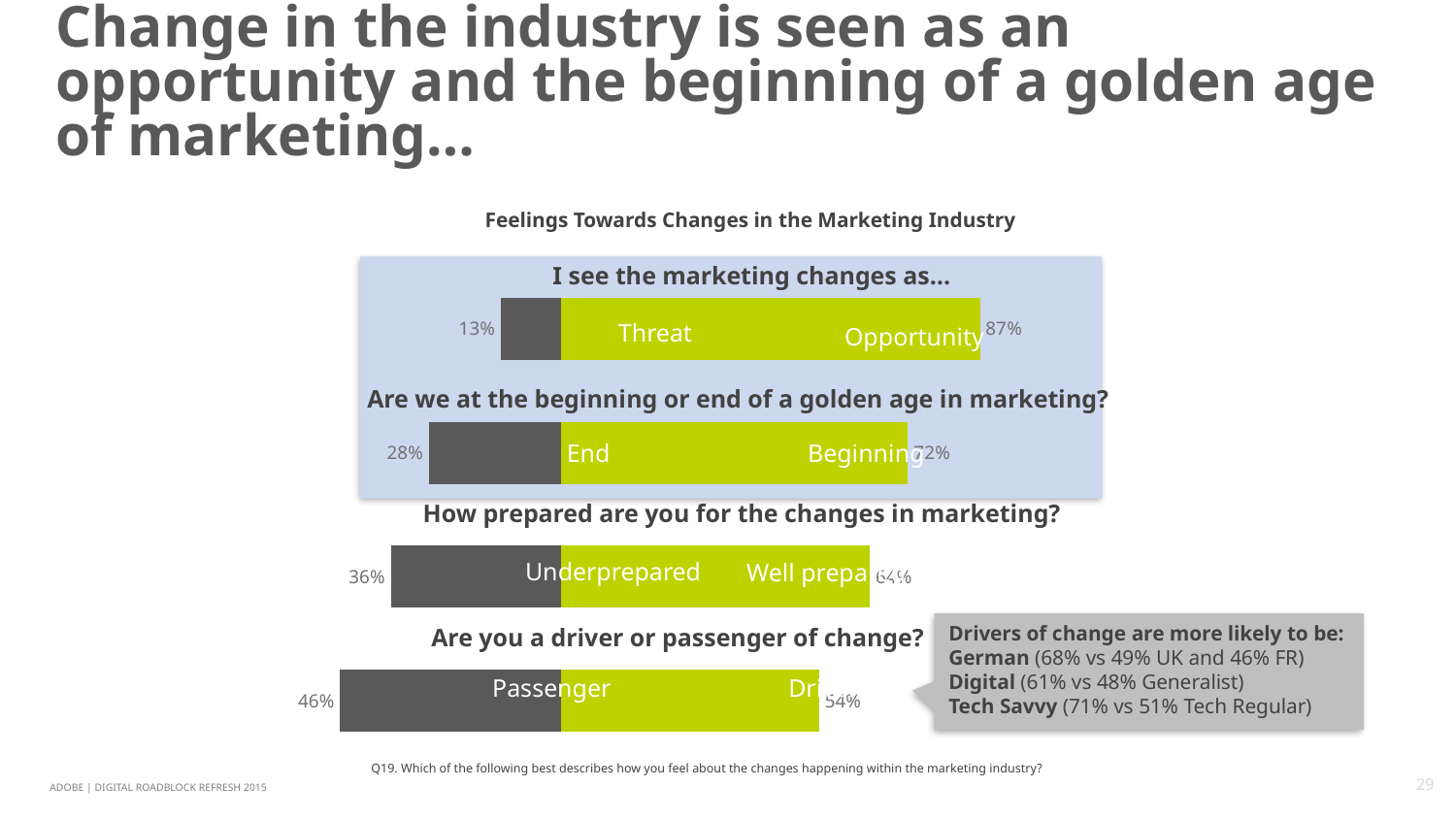
What is the title of the chart on the slide? Feelings Towards Changes in the Marketing Industry Which of the four questions shows the largest share for the green (positive) response? I see the marketing changes as... (Opportunity, 87%) What percentage of respondents think we are at the beginning of a golden age in marketing? 72% What is the difference in percentage points between those who see the changes as an opportunity and those who see them as a threat? 74 What percentage of respondents describe themselves as a passenger of change? 46% Which of the four questions shows the smallest share for the dark grey (negative) response? I see the marketing changes as... (Threat, 13%) What percentage of respondents think we are at the end of a golden age in marketing? 28% Which is larger: the share who say they are a driver of change or the share who say they are a passenger? Driver What percentage of respondents say they are underprepared for the changes in marketing? 36% What percentage of respondents see the marketing changes as a threat? 13% What type of chart is used to show the feelings towards changes in the marketing industry? Bar chart What percentage of respondents see the marketing changes as an opportunity? 87%